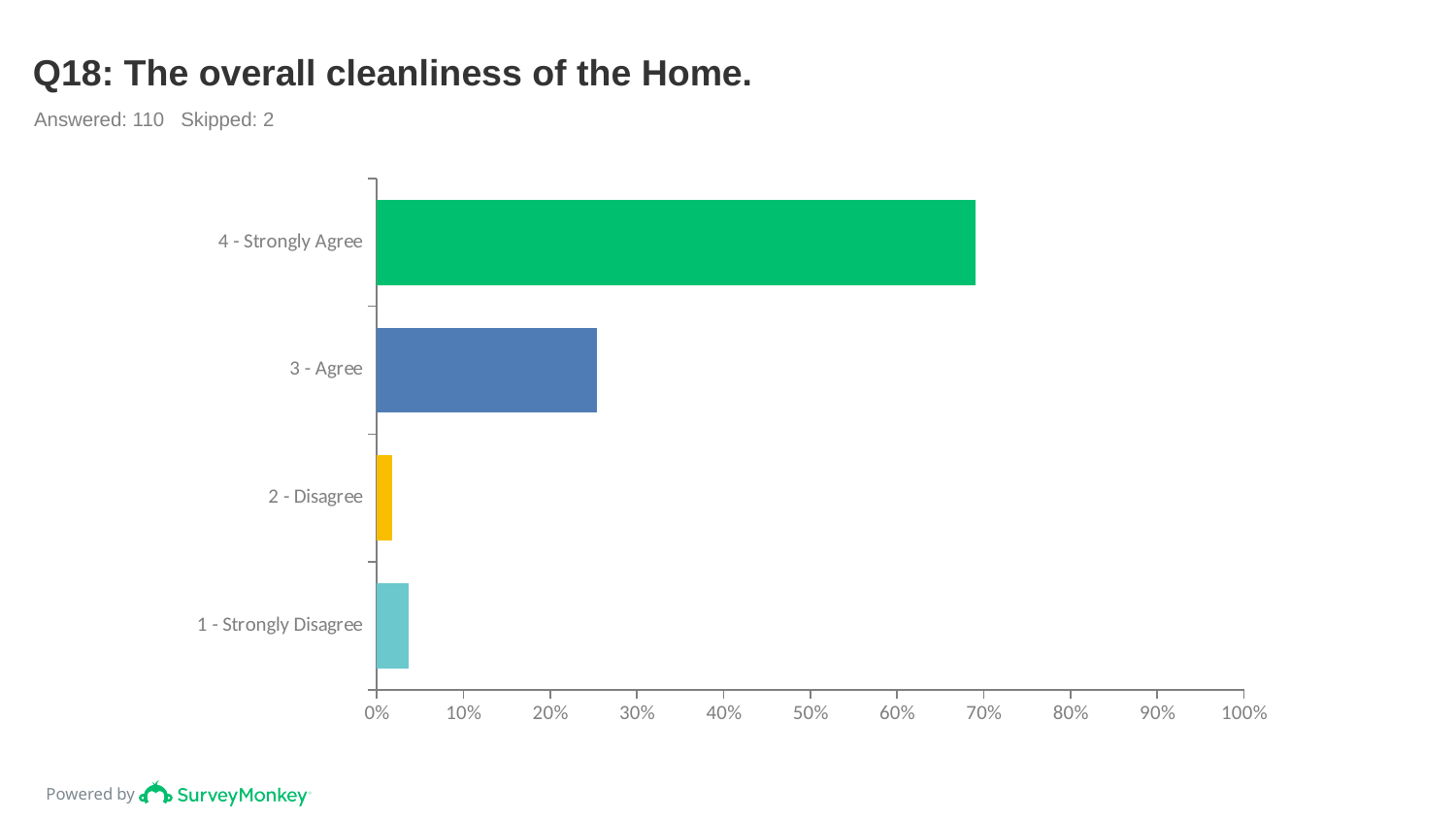
What kind of chart is shown on the slide? bar chart How many respondents answered the question according to the slide? 110 Which is larger, the value for 3 - Agree or the value for 1 - Strongly Disagree? 3 - Agree Is the value for 1 - Strongly Disagree greater or less than 10%? less Is the value for 4 - Strongly Agree greater or less than 60%? greater Which category has the highest value? 4 - Strongly Agree Is the value for 3 - Agree greater or less than 20%? greater What is the title of the chart? Q18: The overall cleanliness of the Home. Which category has the lowest value? 2 - Disagree Which is larger, the value for 1 - Strongly Disagree or the value for 2 - Disagree? 1 - Strongly Disagree How many categories are plotted in the chart? 4